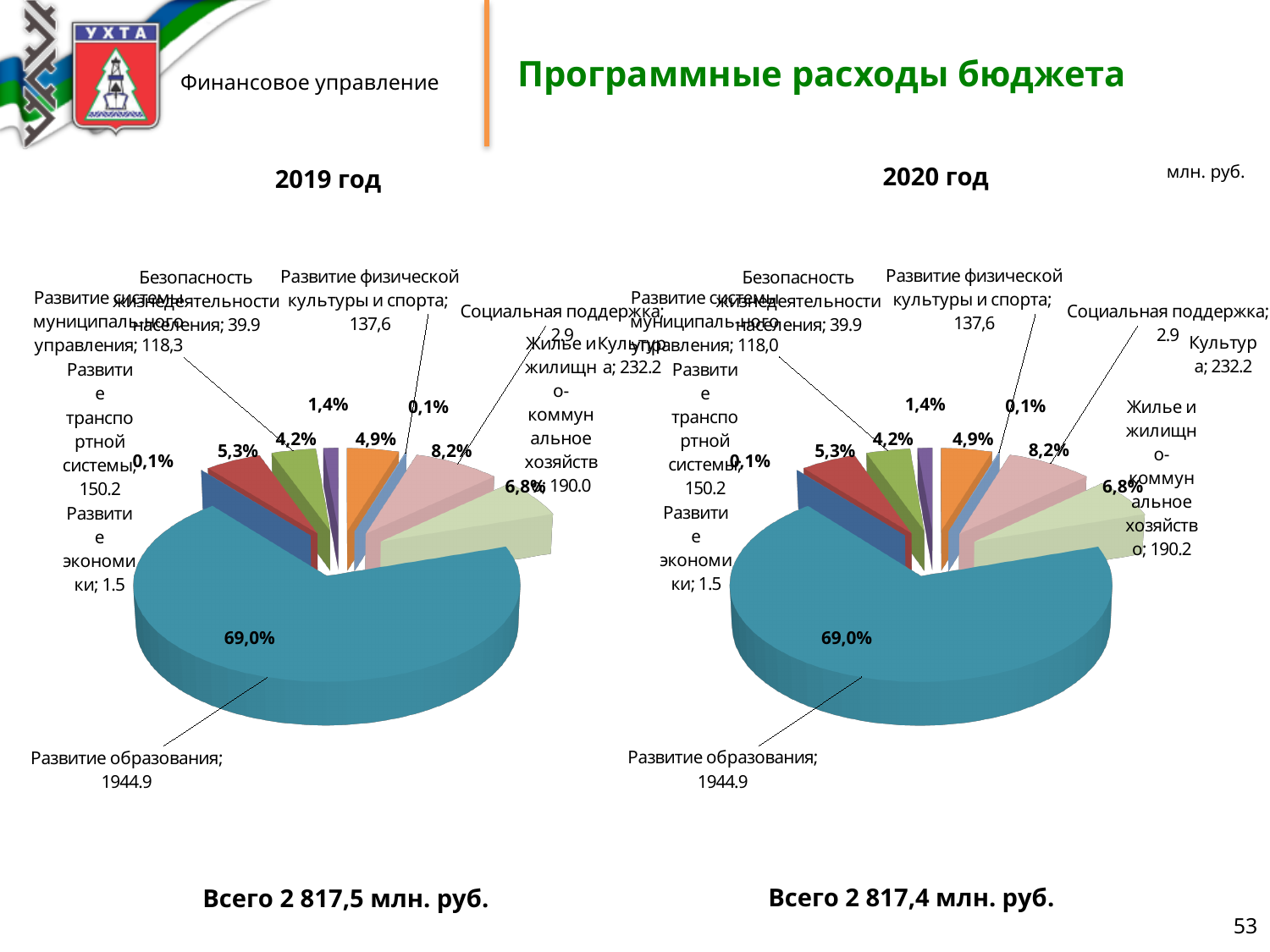
In the 2020 год chart, what share of the pie does Развитие транспортной системы represent? 5,3% In the 2019 год chart, what is the value for Развитие образования? 1944.9 In the 2019 год chart, what share of the pie does Культура represent? 8,2% What type of chart is used for the 2019 год chart? pie chart In the 2020 год chart, what is the difference between the values for Культура (232.2) and Развитие транспортной системы (150.2)? 82.0 How many categories are shown in the 2019 год chart? 9 In the 2020 год chart, what is the value for Развитие системы муниципального управления? 118,0 In the 2020 год chart, what is the value for Жилье и жилищно-коммунальное хозяйство? 190.2 In the 2019 год chart, which is larger: Культура or Развитие физической культуры и спорта? Культура In the 2020 год chart, which category has the largest slice? Развитие образования What total is stated below the 2020 год chart? Всего 2 817,4 млн. руб. In the 2019 год chart, what is the value for Развитие системы муниципального управления? 118,3